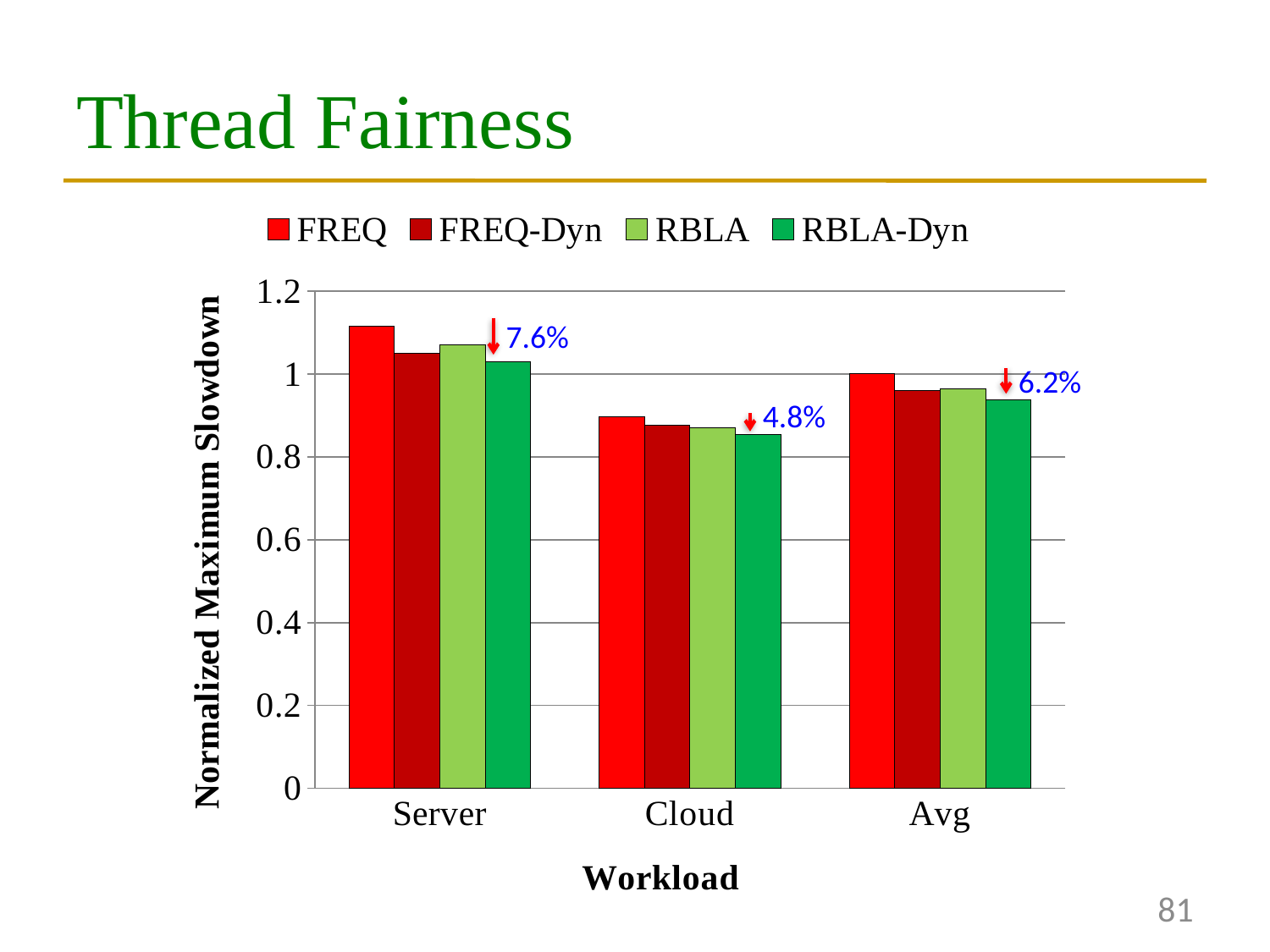
What is the label of the y axis? Normalized Maximum Slowdown Is the RBLA-Dyn value for Cloud greater or less than 0.8? greater What percentage reduction is annotated above the Cloud group? 4.8% Which workload has the lowest RBLA-Dyn value? Cloud What percentage reduction is annotated above the Server group? 7.6% How many series does the legend list? 4 Is the FREQ value for Cloud greater or less than 1? less What percentage reduction is annotated above the Avg group? 6.2% What kind of chart is shown on the slide? bar chart Is the FREQ value for Server greater or less than 1? greater Which workload has the highest FREQ value? Server How many workload categories are shown on the x axis? 3